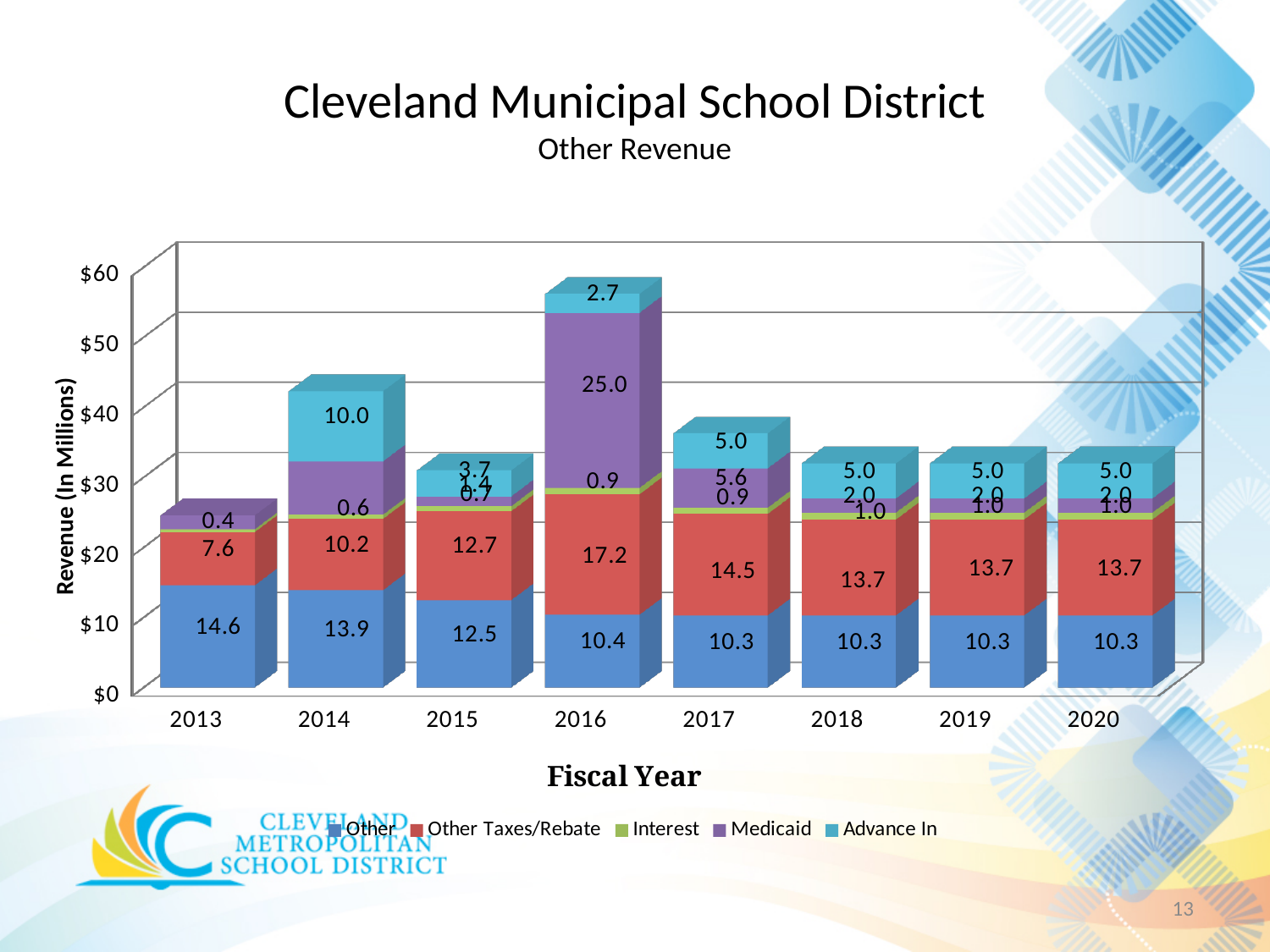
What is the value for Other in 2013? 14.6 In which fiscal year is the Other value highest? 2013 How many fiscal years are shown on the x axis? 8 What is the value for Advance In in 2014? 10.0 How many series does the legend list? 5 What is the value for Medicaid in 2016? 25.0 What is the difference between the Other Taxes/Rebate values for 2016 and 2017? 2.7 Which is larger in 2015, the Other value or the Other Taxes/Rebate value? Other Taxes/Rebate Is the total of the 2016 bar greater or less than $50? greater What is the value for Other Taxes/Rebate in 2017? 14.5 In which fiscal year is the Medicaid value highest? 2016 What is the total of the stacked bar for 2018? 32.0